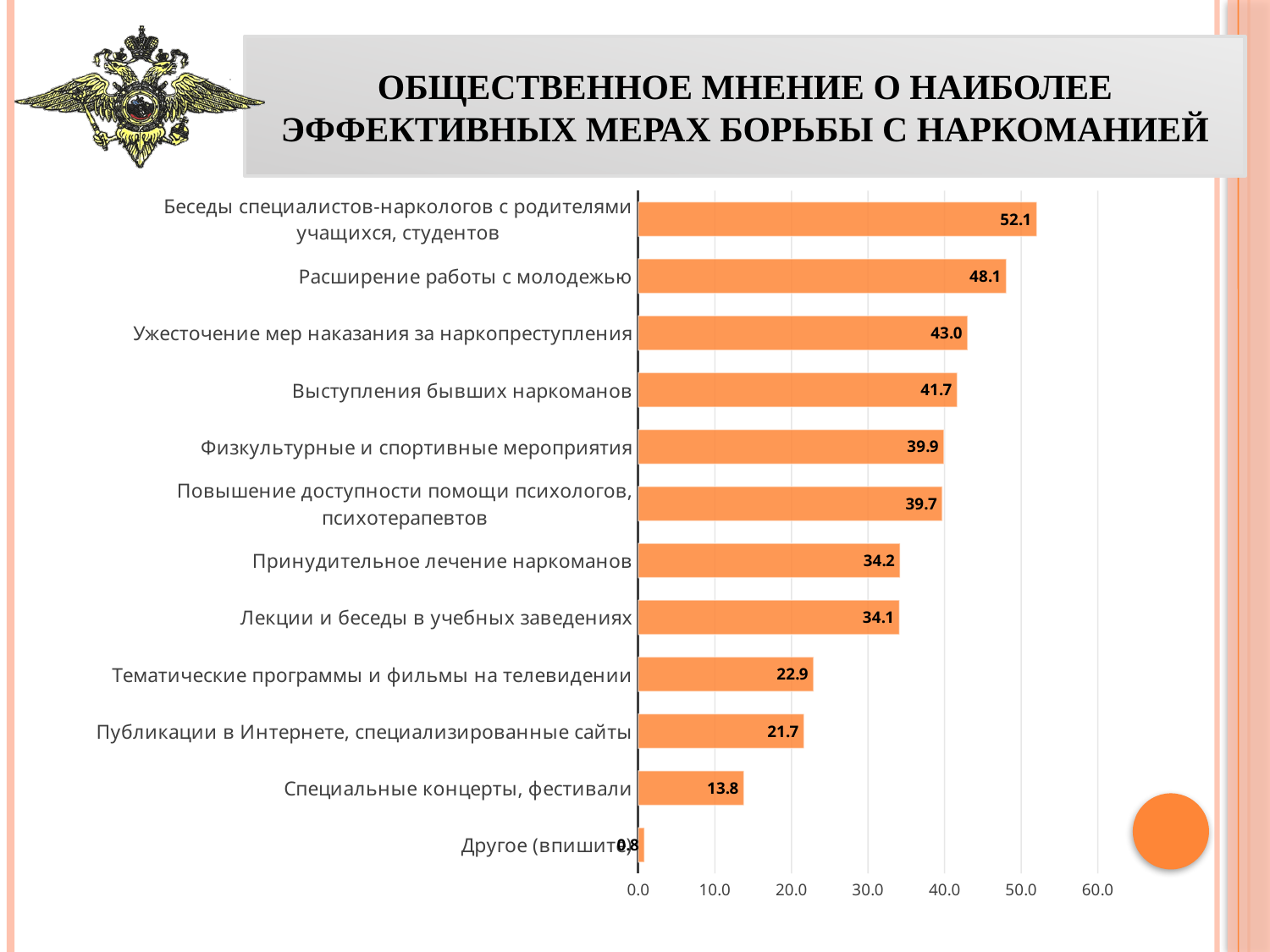
What kind of chart is shown on the slide? Bar chart Which category has the highest value? Беседы специалистов-наркологов с родителями учащихся, студентов What is the difference between the values for "Тематические программы и фильмы на телевидении" and "Публикации в Интернете, специализированные сайты"? 1.2 Which category has the lowest value? Другое (впишите) What colour are the bars in the chart? Orange What is the difference between the values for "Ужесточение мер наказания за наркопреступления" and "Выступления бывших наркоманов"? 1.3 How many categories are shown in the chart? 12 What value is shown for "Расширение работы с молодежью"? 48.1 What value is shown for "Принудительное лечение наркоманов"? 34.2 What value is shown for "Специальные концерты, фестивали"? 13.8 Is the value for "Расширение работы с молодежью" greater or less than 40.0? greater Which is larger: the value for "Физкультурные и спортивные мероприятия" or for "Лекции и беседы в учебных заведениях"? Физкультурные и спортивные мероприятия